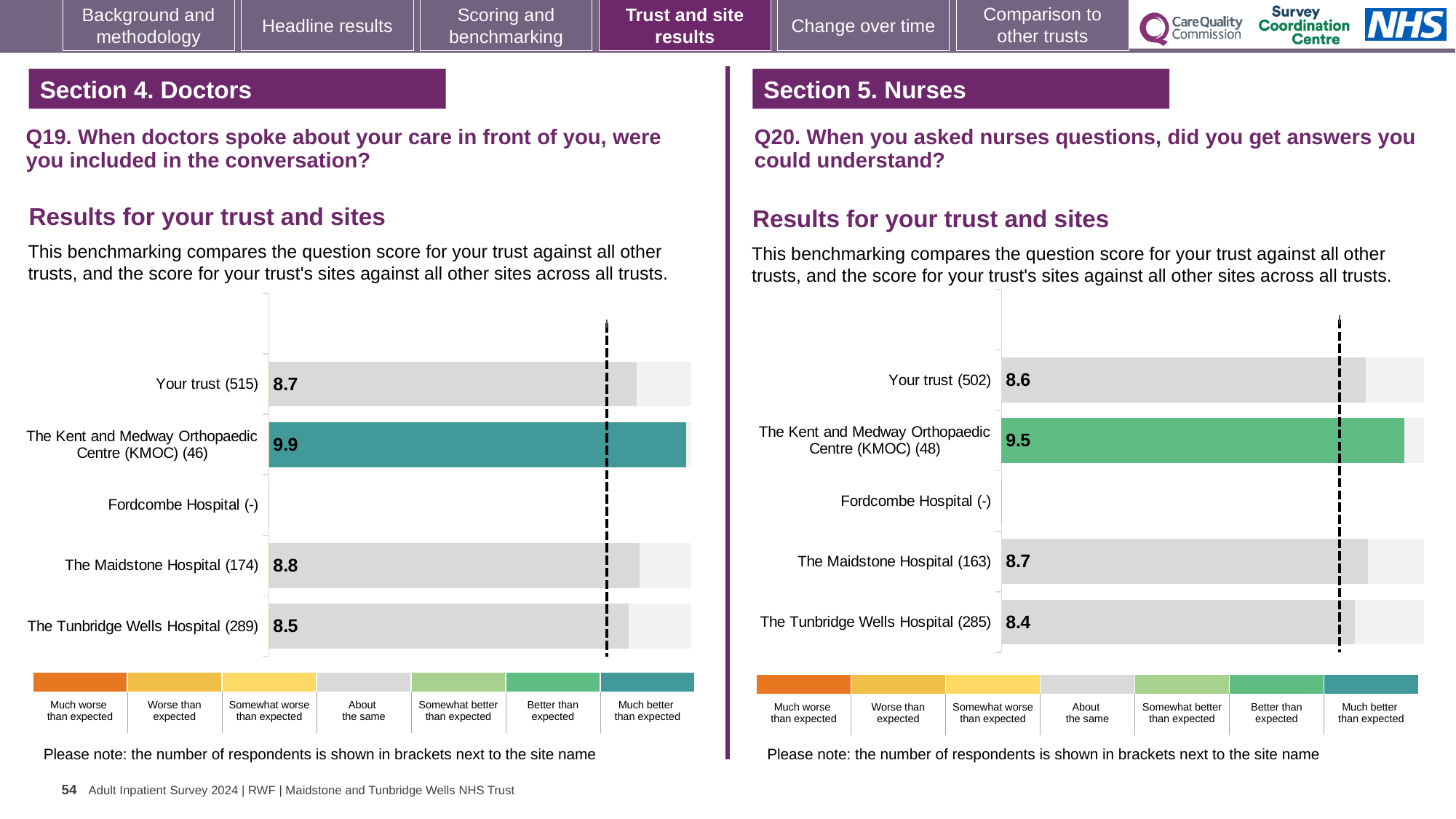
How many trust/site labels are listed in the Q19 chart on the left? 5 In the Q20 chart on the right, which site has the highest score? The Kent and Medway Orthopaedic Centre (KMOC) In the Q20 chart on the right, what is the difference between the scores for The Kent and Medway Orthopaedic Centre (KMOC) and Your trust? 0.9 In the Q20 chart on the right, what is the score for The Maidstone Hospital? 8.7 In the Q20 chart on the right, which is larger: the score for Your trust or the score for The Tunbridge Wells Hospital? Your trust In the Q19 chart on the left, what is the score for Your trust? 8.7 What kind of chart is used for the Q20 results on the right? Bar chart In the Q19 chart on the left, what is the difference between the scores for The Maidstone Hospital and The Tunbridge Wells Hospital? 0.1 In the Q19 chart on the left, which site with a score shown has the lowest score? The Tunbridge Wells Hospital In the Q20 chart on the right, what is the score for The Tunbridge Wells Hospital? 8.4 In the Q19 chart on the left, which site has the highest score? The Kent and Medway Orthopaedic Centre (KMOC) In the Q19 chart on the left, what is the score for The Kent and Medway Orthopaedic Centre (KMOC)? 9.9